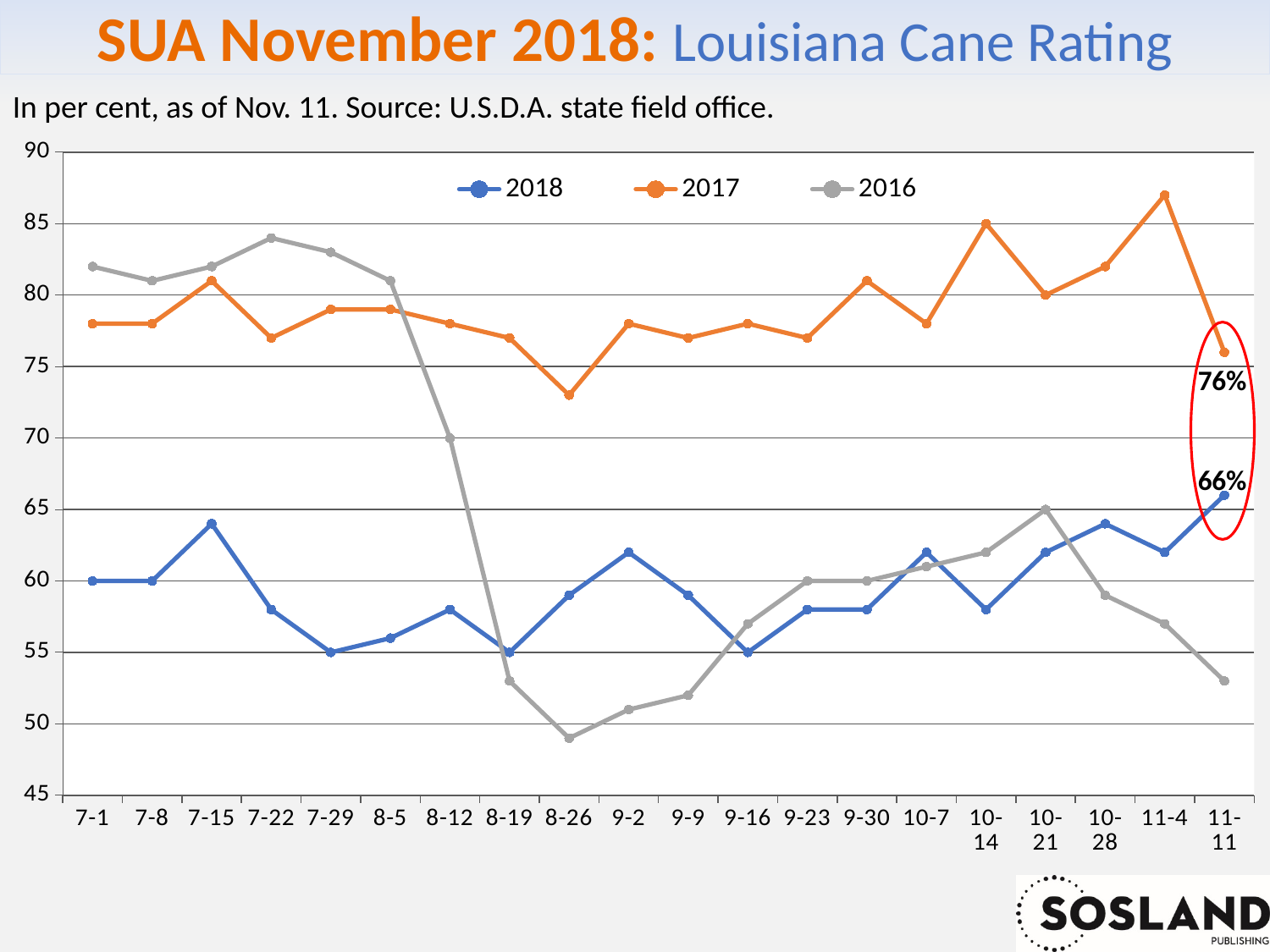
What is the 2017 value at 11-11? 76% At which date does the 2017 series reach its highest value? 11-4 What is the 2018 value at 11-11? 66% What type of chart is shown on the slide? line chart At which date does the 2016 series reach its lowest value? 8-26 Is the 2016 value at 8-26 greater or less than 50? less How many series does the legend list? 3 Is the 2017 value at 11-4 greater or less than 85? greater At 11-11, which series has the larger value, 2017 or 2018? 2017 Does the 2016 series rise or fall between 8-5 and 8-26? fall How many dates are shown on the x axis? 20 What is the difference between the 2017 and 2018 values at 11-11? 10 percentage points